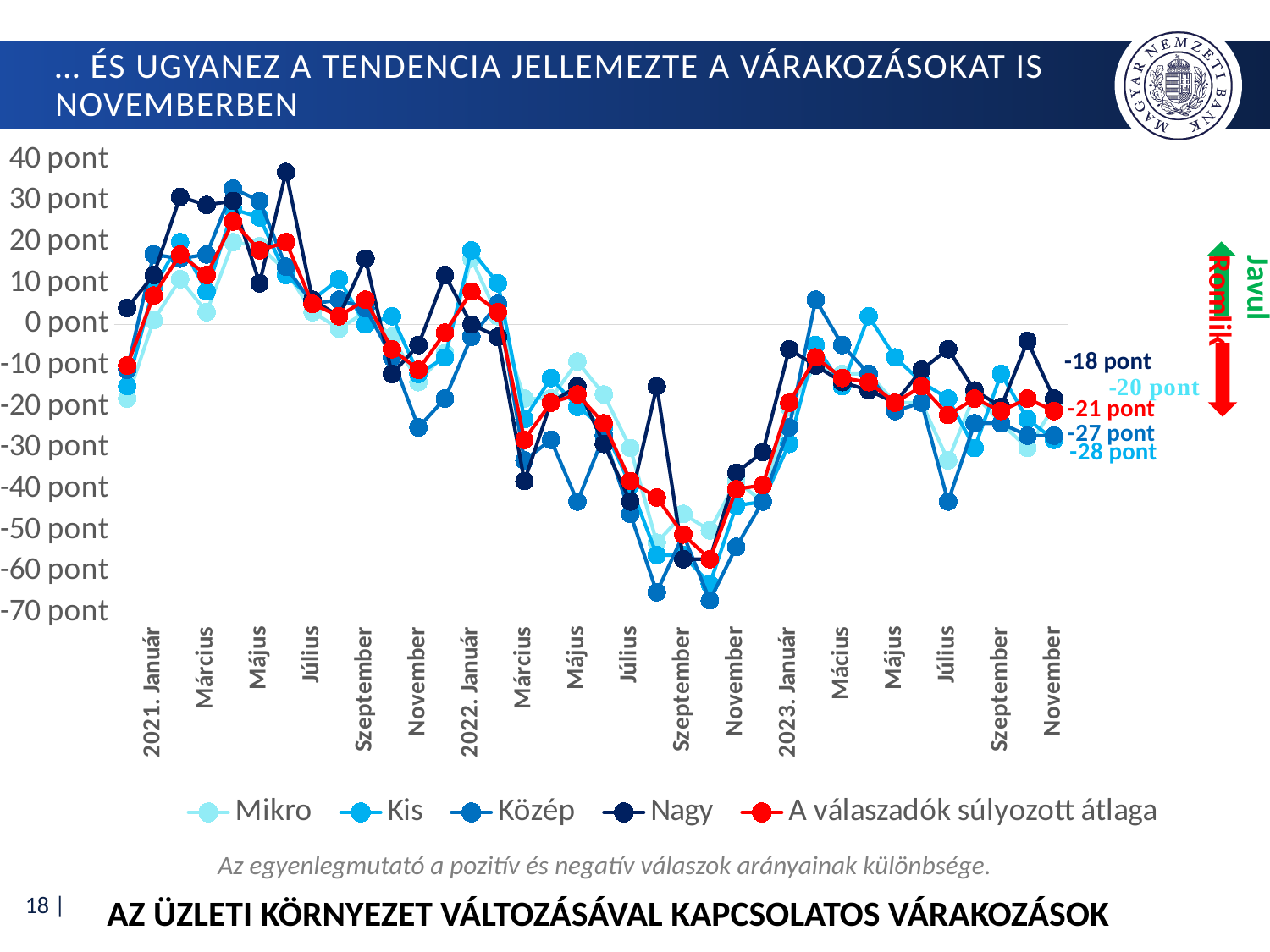
What kind of chart is shown on the slide? line chart Is the value for the Nagy series in September 2022 greater or less than -50 pont? less How many series does the legend list? 5 What is the value labelled for 'A válaszadók súlyozott átlaga' at the end of the chart (November 2023)? -21 pont Which series has the highest labelled value at the end of the chart (November 2023)? Nagy At the end of the chart, which is higher: the Nagy series or the Közép series? Nagy What is the lowest value labelled at the right end of the chart? -28 pont What is the value labelled for the Nagy series at the end of the chart (November 2023)? -18 pont What is the value labelled for the Közép series at the end of the chart (November 2023)? -27 pont Which legend entry is drawn in red? A válaszadók súlyozott átlaga Does the weighted average ('A válaszadók súlyozott átlaga') rise or fall from January 2021 to May 2021? rises What is the difference between the Nagy value (-18 pont) and the weighted average value (-21 pont) labelled at the end of the chart? 3 pont